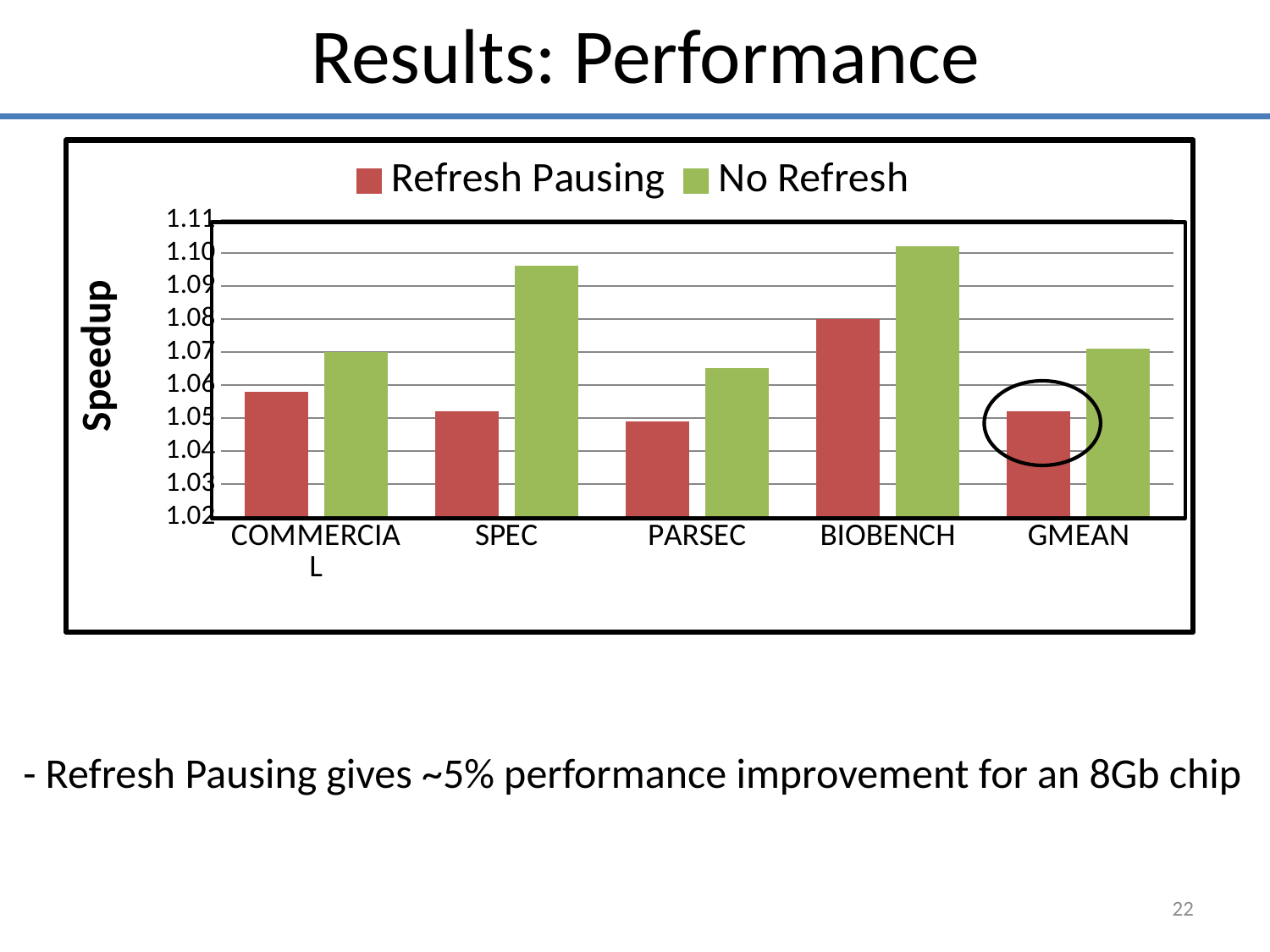
How many categories are shown on the x axis? 5 Is the Refresh Pausing value for BIOBENCH greater or less than 1.06? greater Is the No Refresh value for SPEC greater or less than 1.09? greater Is the Refresh Pausing value for GMEAN greater or less than 1.06? less What kind of chart is shown on the slide? bar chart What is the label of the y axis? Speedup Which category has the highest No Refresh speedup? BIOBENCH How many series does the legend list? 2 Which category has the highest Refresh Pausing speedup? BIOBENCH Which category has the lowest No Refresh speedup? PARSEC For COMMERCIAL, which series has the larger speedup, Refresh Pausing or No Refresh? No Refresh